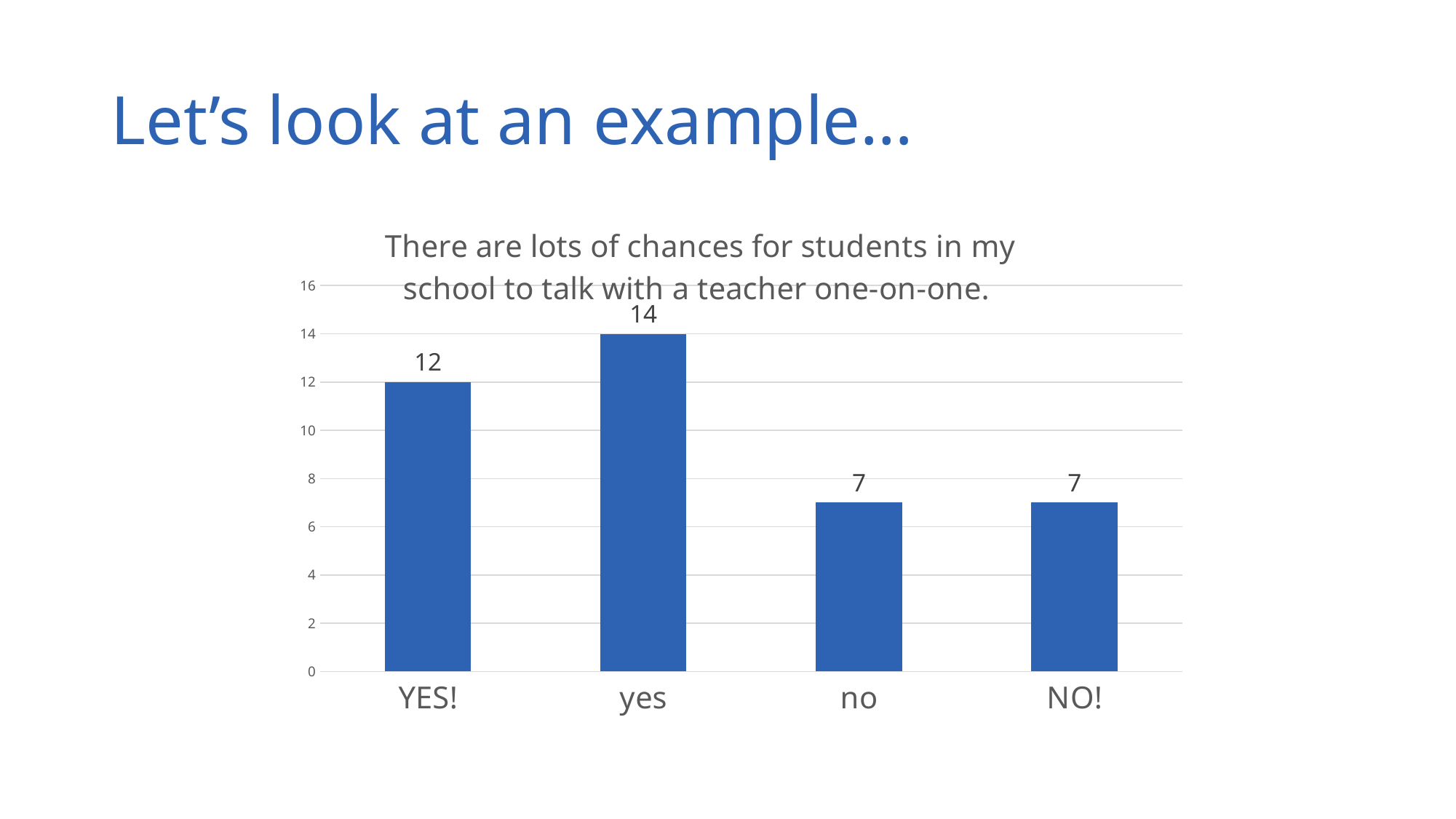
What is the title of the chart? There are lots of chances for students in my school to talk with a teacher one-on-one. What is the difference between the values for "yes" and "YES!"? 2 What kind of chart is shown on the slide? bar chart Which is larger, the value for "YES!" or the value for "no"? YES! What is the value for the "yes" category? 14 What is the difference between the values for "YES!" and "NO!"? 5 Is the value for "yes" greater or less than 10? greater Which category has the highest value? yes What is the value for the "YES!" category? 12 What is the maximum value shown on the y axis? 16 How many categories are shown on the x axis? 4 What is the value for the "no" category? 7